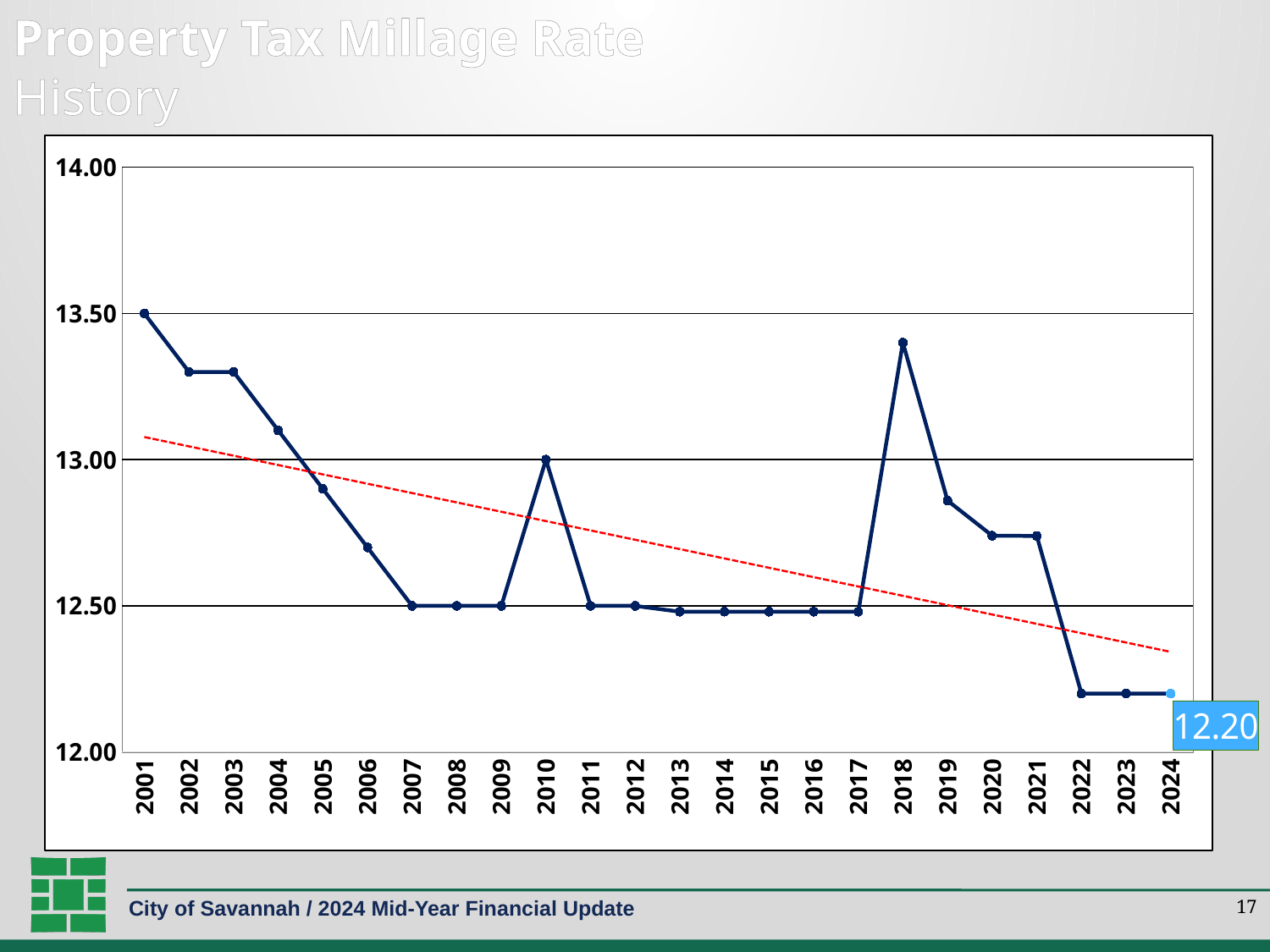
Do the values generally rise or fall from 2001 to 2024? fall What is the difference between the values for 2001 and 2024? 1.30 What is the value for 2001? 13.50 Which is larger, the value for 2018 or the value for 2017? 2018 Which year has the highest value? 2001 What kind of chart is shown? line chart What is the value for 2024? 12.20 What is the value for 2007? 12.50 Is the value for 2006 greater or less than 13.00? less Is the value for 2022 greater or less than 12.50? less How many years are plotted on the x axis? 24 What is the value for 2010? 13.00